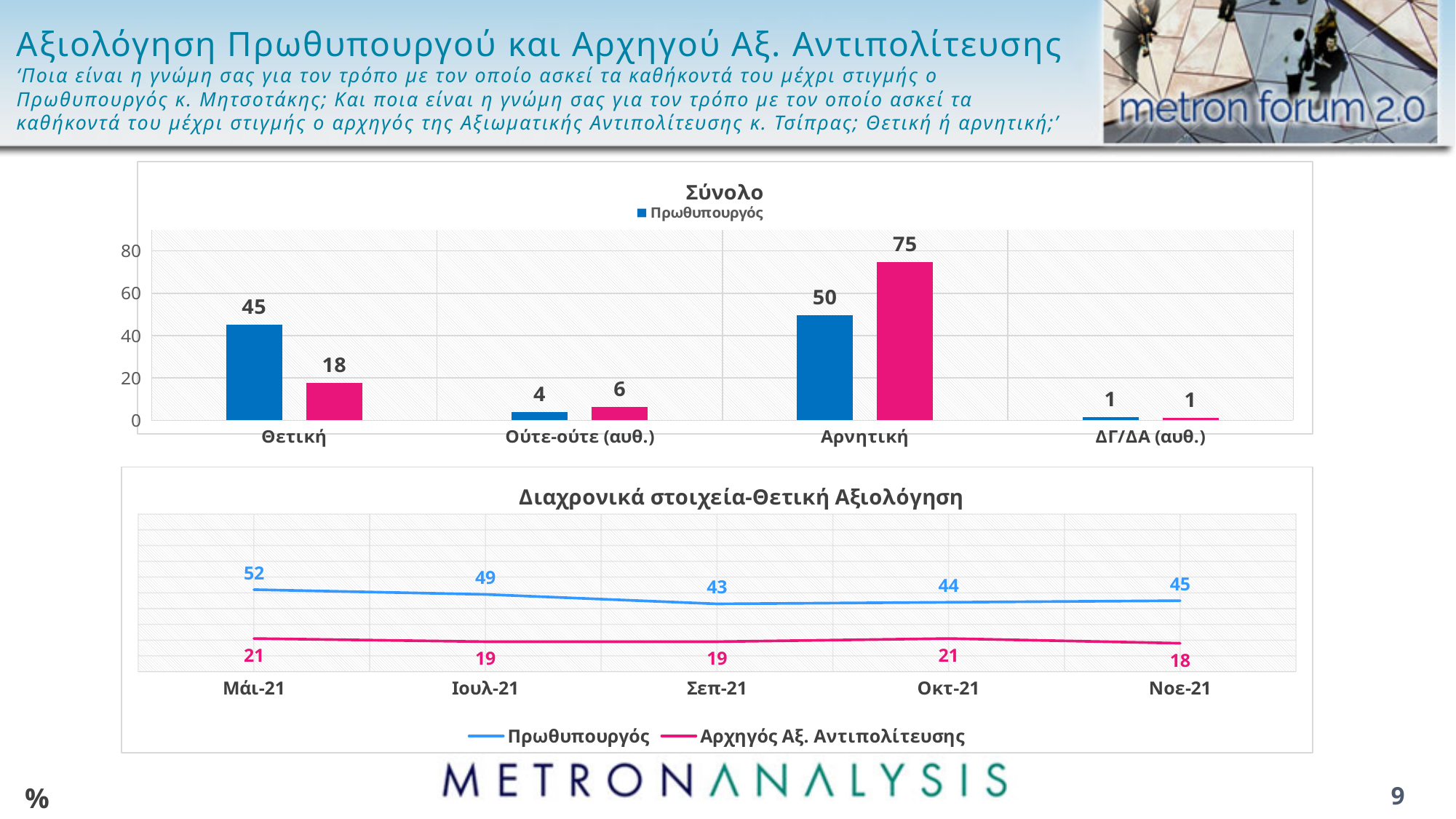
In the 'Σύνολο' chart, which is larger for Ούτε-ούτε (αυθ.): the Πρωθυπουργός bar or the pink bar? the pink bar In the 'Διαχρονικά στοιχεία-Θετική Αξιολόγηση' chart, at which date is the Πρωθυπουργός value highest? Μάι-21 In the 'Διαχρονικά στοιχεία-Θετική Αξιολόγηση' chart, what is the difference between the Πρωθυπουργός and Αρχηγός Αξ. Αντιπολίτευσης values for Οκτ-21? 23 What kind of chart is the 'Σύνολο' chart? bar chart In the 'Διαχρονικά στοιχεία-Θετική Αξιολόγηση' chart, what is the Πρωθυπουργός value for Σεπ-21? 43 In the 'Διαχρονικά στοιχεία-Θετική Αξιολόγηση' chart, how many series does the legend list? 2 In the 'Διαχρονικά στοιχεία-Θετική Αξιολόγηση' chart, what is the Αρχηγός Αξ. Αντιπολίτευσης value for Νοε-21? 18 In the 'Σύνολο' chart, how many categories are shown on the x axis? 4 In the 'Σύνολο' chart, what is the value of the pink bar for Αρνητική? 75 In the 'Σύνολο' chart, which category has the highest Πρωθυπουργός value? Αρνητική In the 'Σύνολο' chart, what is the value of the Πρωθυπουργός bar for Θετική? 45 In the 'Σύνολο' chart, what is the difference between the Πρωθυπουργός bar and the pink bar for Θετική? 27